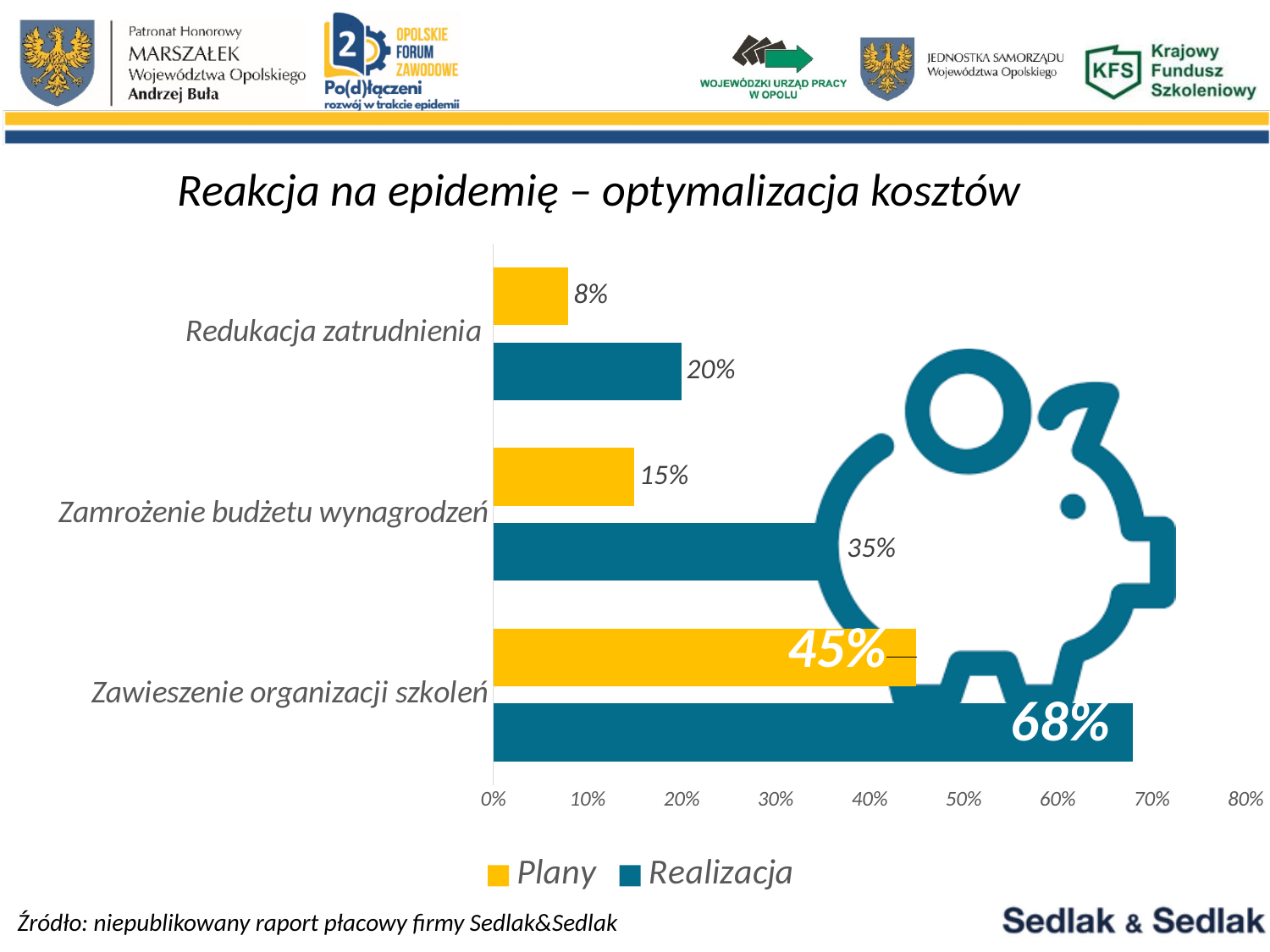
How many series does the legend list? 2 Which is larger for Redukacja zatrudnienia: the Plany value or the Realizacja value? Realizacja What is the Plany value for Redukacja zatrudnienia? 8% Which category has the highest Realizacja value? Zawieszenie organizacji szkoleń What is the Realizacja value for Zamrożenie budżetu wynagrodzeń? 35% What is the difference between the Realizacja and Plany values for Zamrożenie budżetu wynagrodzeń? 20% What is the Plany value for Zawieszenie organizacji szkoleń? 45% What is the title of the chart on the slide? Reakcja na epidemię – optymalizacja kosztów What is the Realizacja value for Zawieszenie organizacji szkoleń? 68% How many categories are shown on the chart? 3 Which category has the lowest Plany value? Redukacja zatrudnienia What kind of chart is shown on the slide? Bar chart